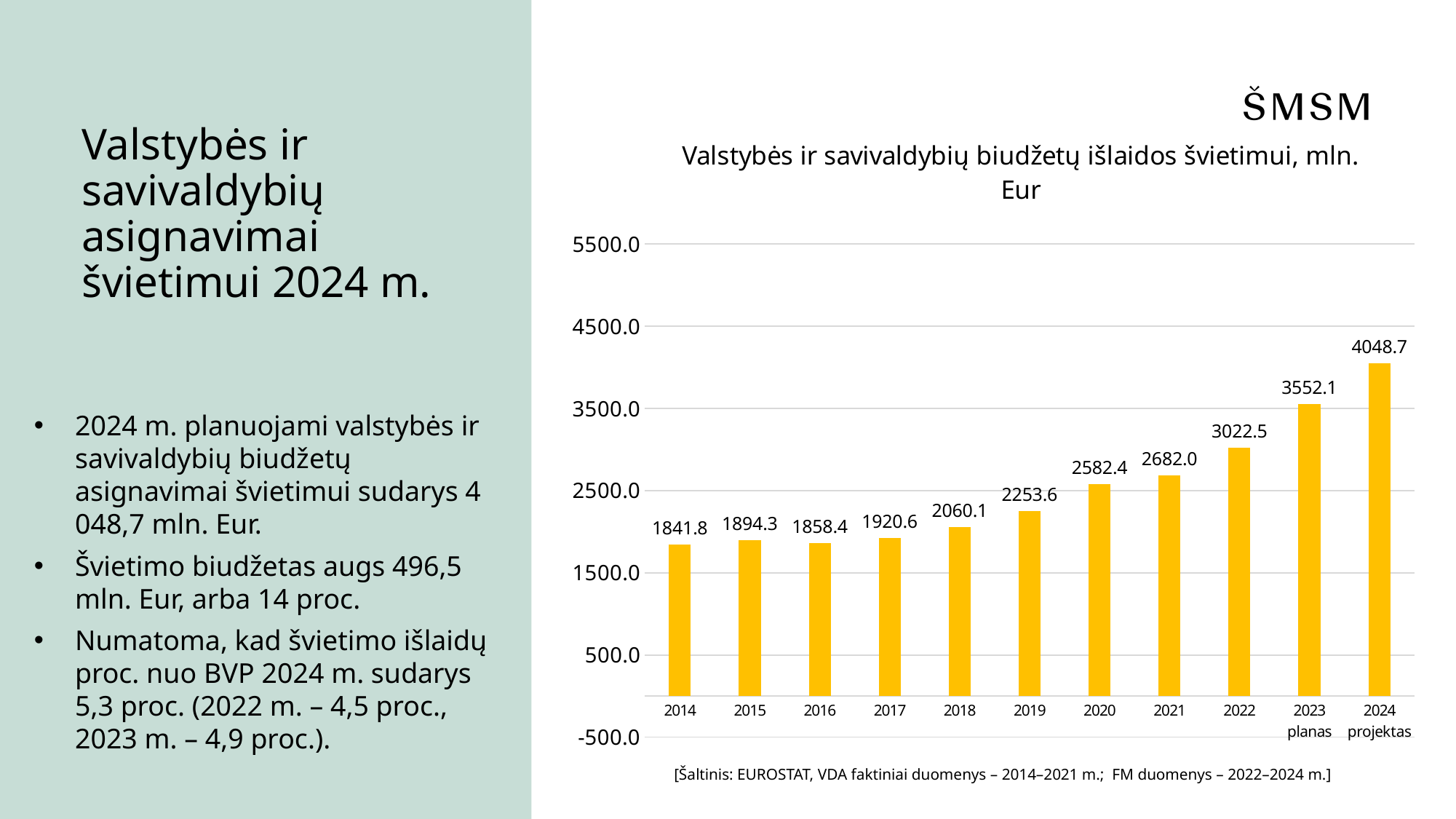
Which year has the lowest value in the chart? 2014 How many bars (years) are shown in the chart? 11 Which year has the highest value in the chart? 2024 projektas What is the title of the chart? Valstybės ir savivaldybių biudžetų išlaidos švietimui, mln. Eur Which is larger, the value for 2015 or the value for 2016? 2015 What is the value for 2014 in the chart? 1841.8 What is the value for 2019 in the chart? 2253.6 Do the values generally rise or fall from 2014 to 2024 projektas? rise What is the value for 2024 projektas in the chart? 4048.7 Is the value for 2020 greater or less than 2500? greater What is the difference between the values for 2022 and 2021? 340.5 What type of chart is shown on the slide? bar chart